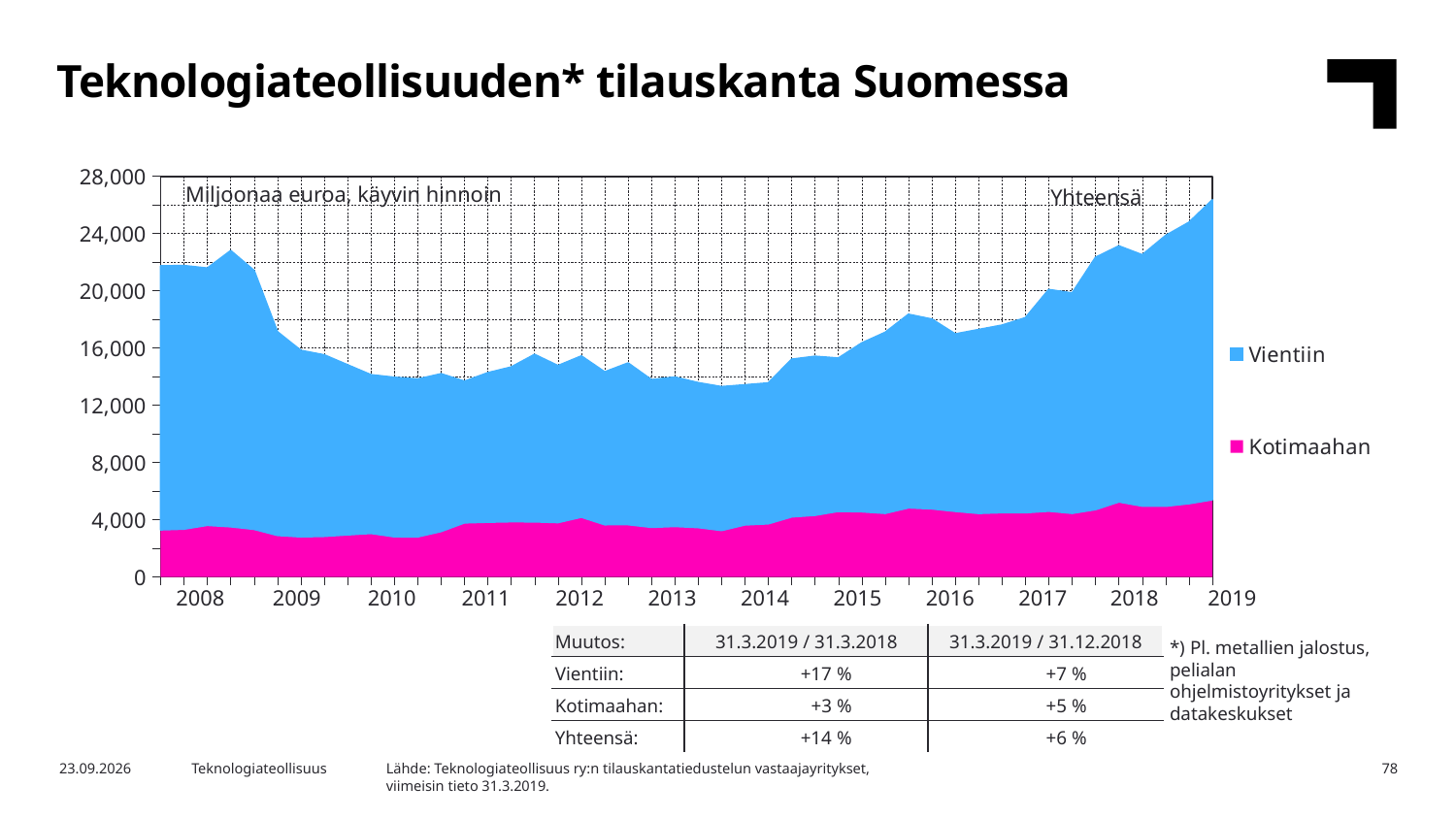
What unit label is shown inside the chart area? Miljoonaa euroa, käyvin hinnoin Is the total order backlog (Yhteensä) at the start of 2014 greater or less than 16,000? less Is the total order backlog (Yhteensä) at the start of 2019 greater or less than 24,000? greater Which two series are listed in the chart legend? Vientiin and Kotimaahan Is the total order backlog higher at the start of 2019 or at the start of 2008? 2019 Is the Kotimaahan value at the start of 2010 greater or less than 4,000? less Which series is larger throughout the chart, Vientiin or Kotimaahan? Vientiin Does the total order backlog rise or fall from 2014 to 2019? rise How many year labels are shown on the x axis? 12 What kind of chart is shown on the slide? Stacked area chart How many series does the chart legend list? 2